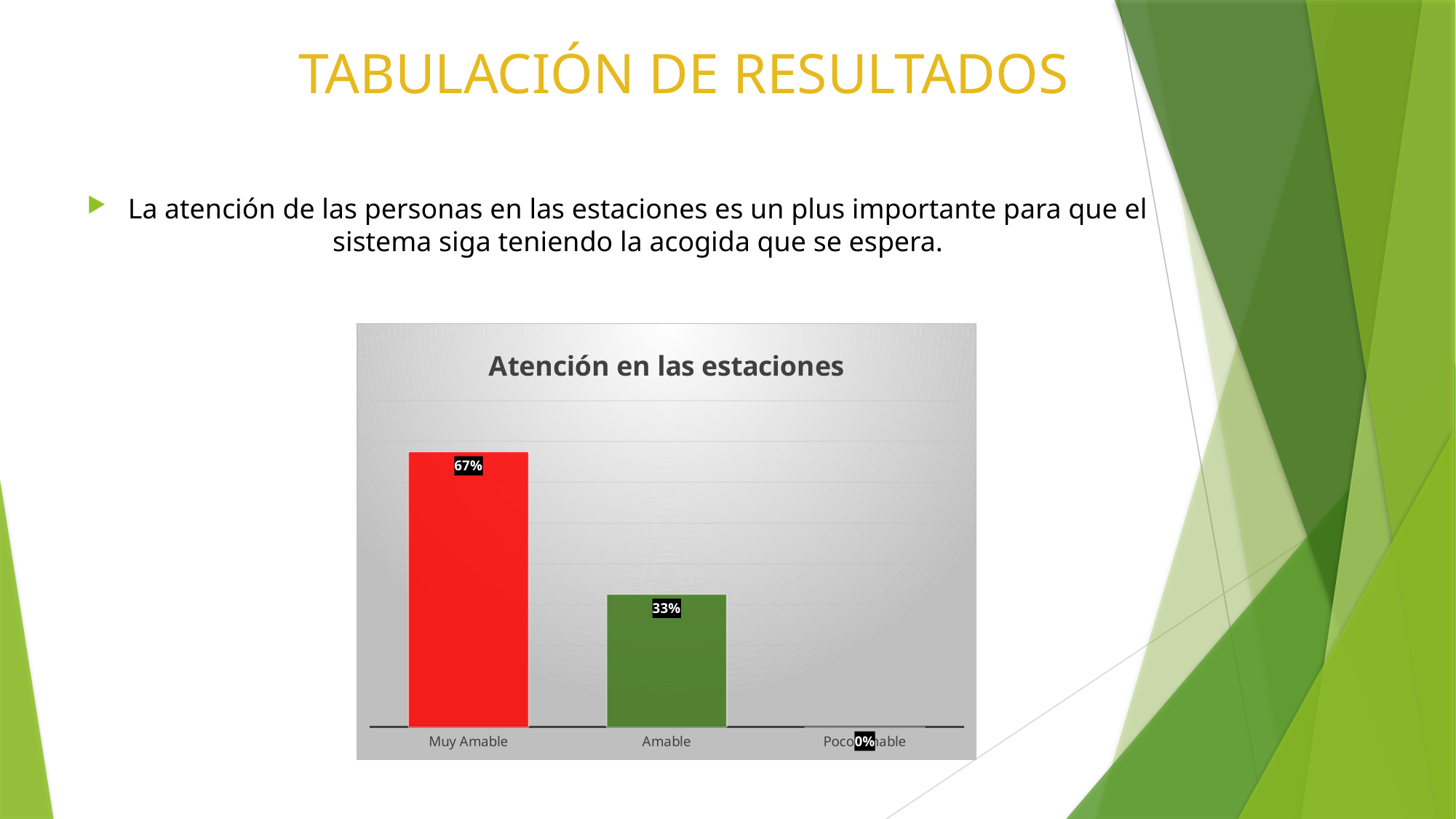
Which category has the lowest value? Poco Amable What kind of chart is shown on the slide? Bar chart Which is larger, the value for Amable or the value for Poco Amable? Amable What is the title of the chart? Atención en las estaciones What is the value for Muy Amable? 67% What is the value for Poco Amable? 0% What colour is the bar for Muy Amable? Red What is the value for Amable? 33% Which category has the highest value? Muy Amable What is the difference between the values for Muy Amable and Amable? 34% How many categories are shown on the x axis? 3 Do the values rise or fall from left to right along the x axis? Fall